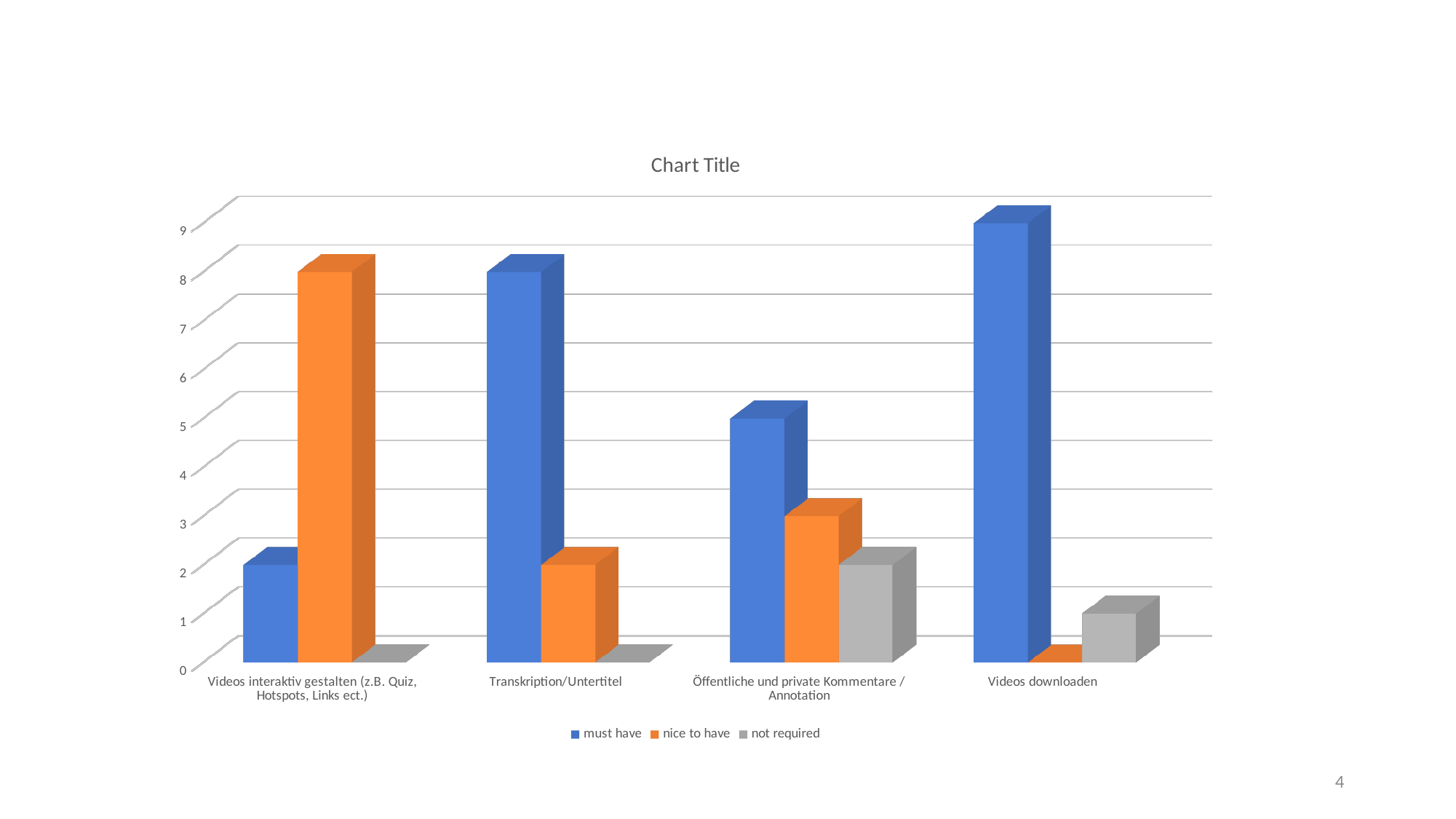
Which is larger for Transkription/Untertitel: the 'must have' value or the 'nice to have' value? must have Is the 'nice to have' value for Transkription/Untertitel greater or less than 4? less Which category has the highest 'must have' value? Videos downloaden Which is larger for Videos interaktiv gestalten: the 'must have' value or the 'nice to have' value? nice to have How many series does the legend list? 3 Which category has the highest 'nice to have' value? Videos interaktiv gestalten (z.B. Quiz, Hotspots, Links ect.) Is the 'must have' value for Öffentliche und private Kommentare / Annotation greater or less than 6? less What is the title of the chart? Chart Title Which category has the lowest 'must have' value? Videos interaktiv gestalten (z.B. Quiz, Hotspots, Links ect.) How many categories are shown on the x axis? 4 What kind of chart is shown on the slide? bar chart Is the 'must have' value for Videos downloaden greater or less than 8? greater